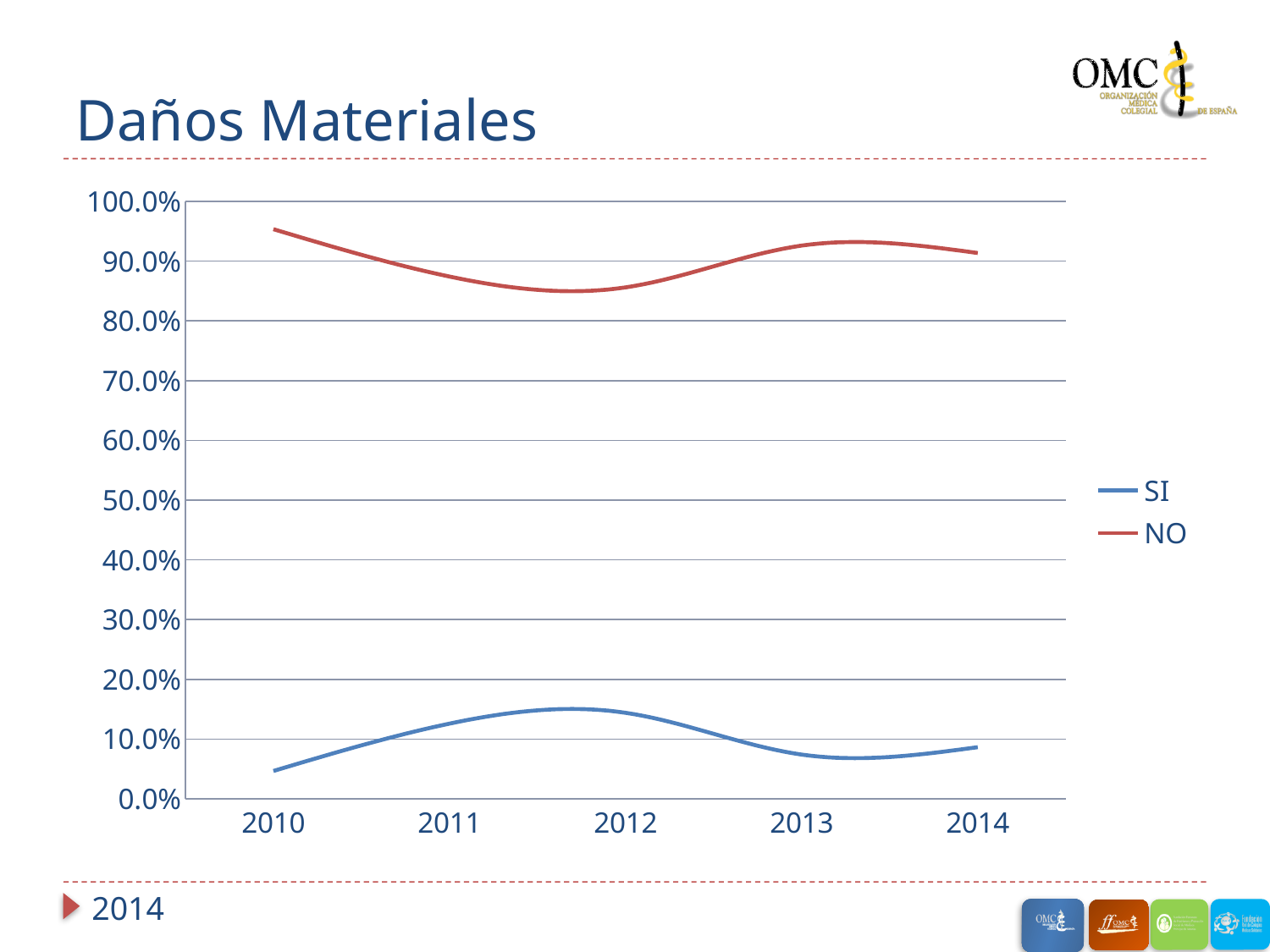
In which year is the NO series at its lowest? 2012 Which is larger, the NO value in 2010 or the NO value in 2012? 2010 What is the title of the chart? Daños Materiales In which year is the SI series at its highest? 2012 Does the SI series rise or fall from 2010 to 2012? rise How many series does the legend list? 2 Is the value for SI in 2012 greater or less than 10.0%? greater Is the value for NO in 2012 greater or less than 90.0%? less How many years are shown on the x axis? 5 Is the value for NO in 2010 greater or less than 90.0%? greater What kind of chart is shown on the slide? line chart Which series is drawn in red? NO